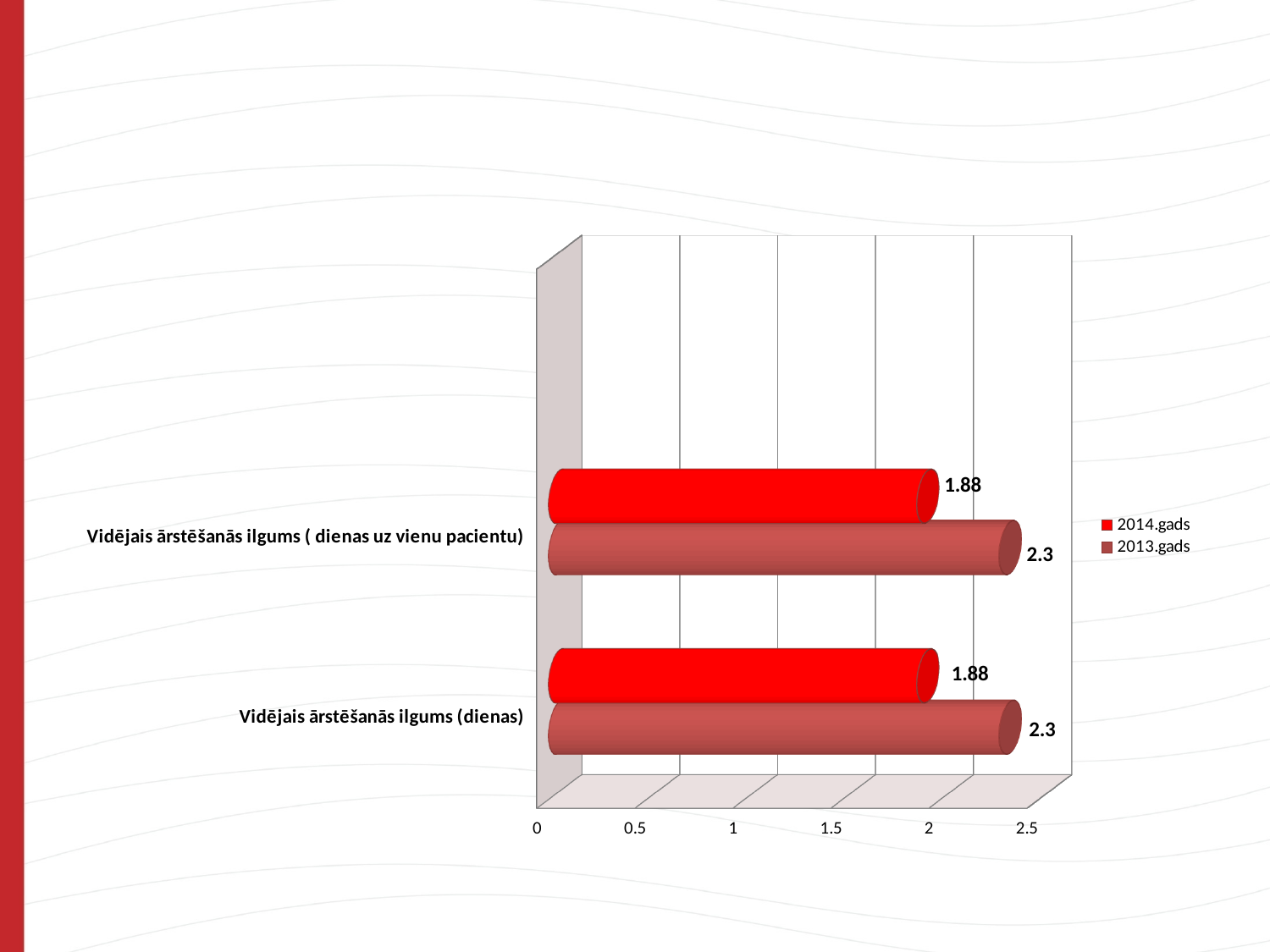
How many categories are shown on the chart? 2 What kind of chart is shown on the slide? Bar chart What is the value for 2014.gads in the category 'Vidējais ārstēšanās ilgums ( dienas uz vienu pacientu)'? 1.88 What is the difference between the 2013.gads and 2014.gads values for 'Vidējais ārstēšanās ilgums (dienas)'? 0.42 What is the value for 2014.gads in the category 'Vidējais ārstēšanās ilgums (dienas)'? 1.88 How many series does the legend list? 2 What is the value for 2013.gads in the category 'Vidējais ārstēšanās ilgums (dienas)'? 2.3 Which series has the larger value for 'Vidējais ārstēšanās ilgums (dienas)', 2014.gads or 2013.gads? 2013.gads Is the value for 2013.gads in 'Vidējais ārstēšanās ilgums (dienas)' greater or less than 2? greater What is the value for 2013.gads in the category 'Vidējais ārstēšanās ilgums ( dienas uz vienu pacientu)'? 2.3 Is the value for 2014.gads in 'Vidējais ārstēšanās ilgums ( dienas uz vienu pacientu)' greater or less than 2? less What are the two series names listed in the legend? 2014.gads and 2013.gads